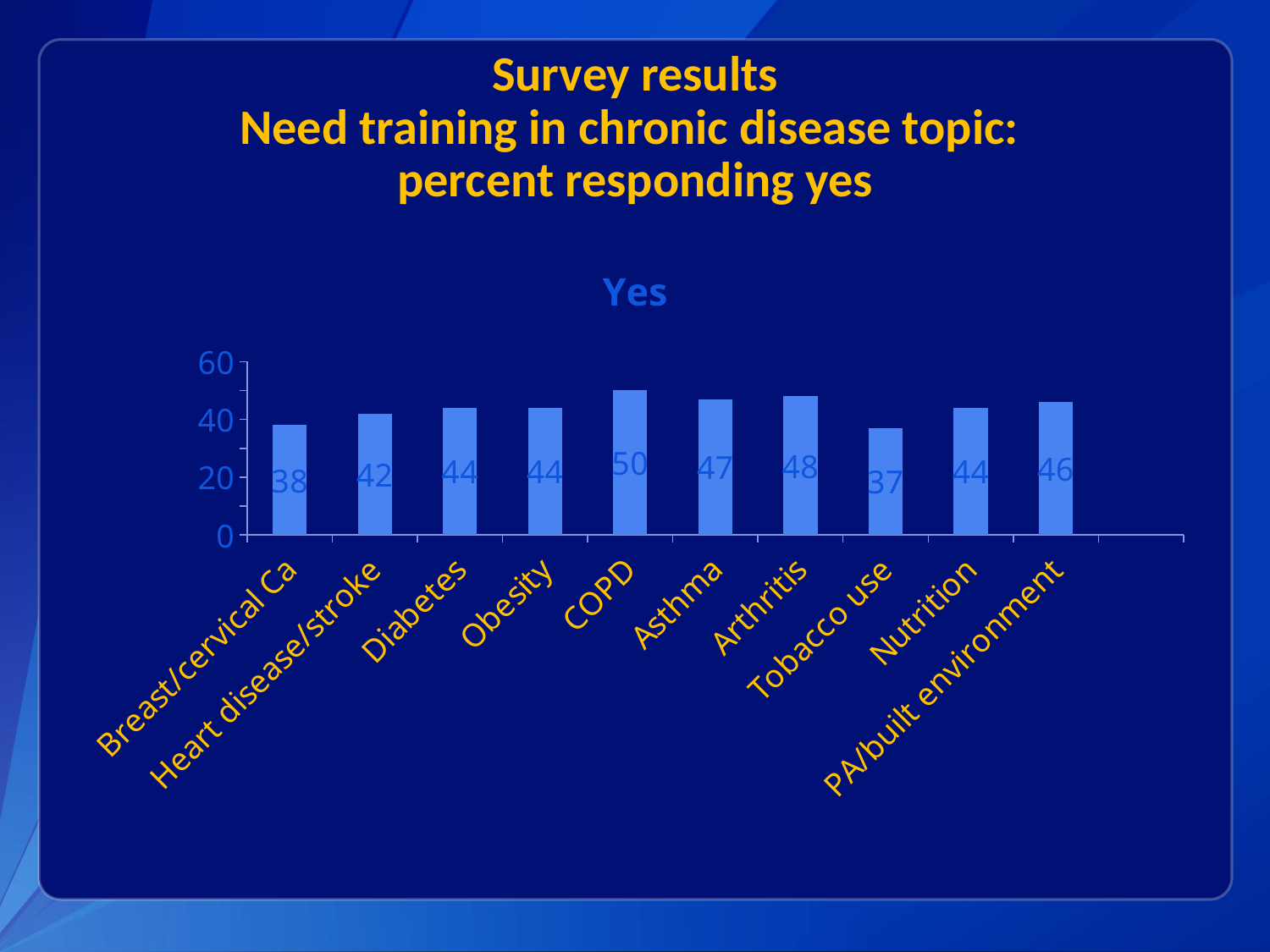
What is the value for PA/built environment? 46 Which category has the lowest value? Tobacco use How many categories are shown on the x axis? 10 What is the value for Diabetes? 44 Which category has the highest value? COPD What is the title of the chart? Yes Which is larger, the value for Asthma or the value for Heart disease/stroke? Asthma What is the difference between the values for COPD and Tobacco use? 13 What kind of chart is shown on the slide? bar chart What is the difference between the values for Arthritis and Breast/cervical Ca? 10 What is the value for COPD? 50 What is the value for Tobacco use? 37